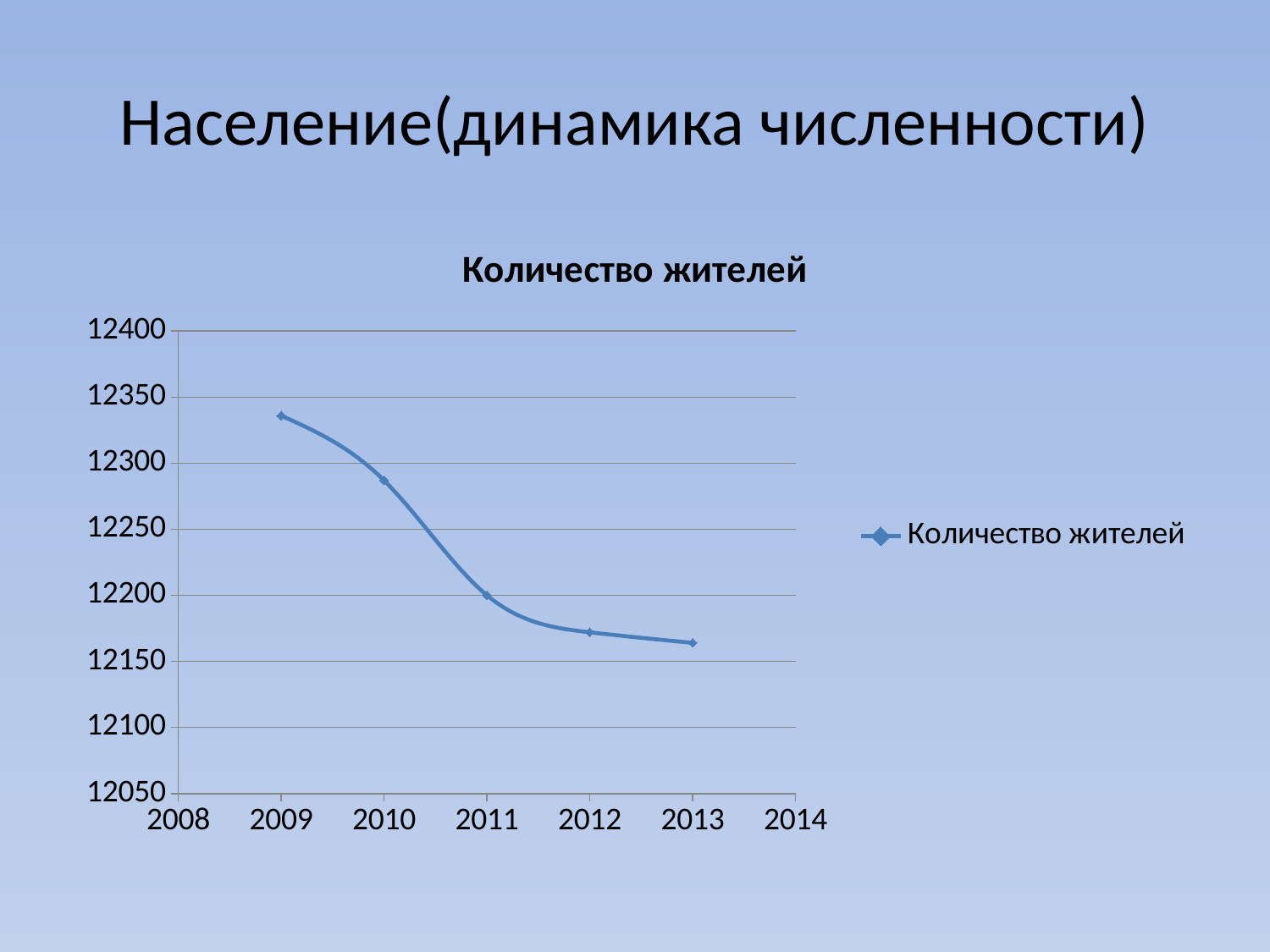
How many series does the legend list? 1 Is the value for 2009 greater or less than 12300? greater What kind of chart is shown on the slide? line chart Do the values rise or fall from 2009 to 2013? fall How many data points are plotted on the line? 5 Which year has the highest number of residents? 2009 Which year has the larger value, 2010 or 2012? 2010 Is the value for 2013 greater or less than 12150? greater Is the value for 2010 greater or less than 12300? less What is the title of the chart? Количество жителей Which year has the lowest number of residents? 2013